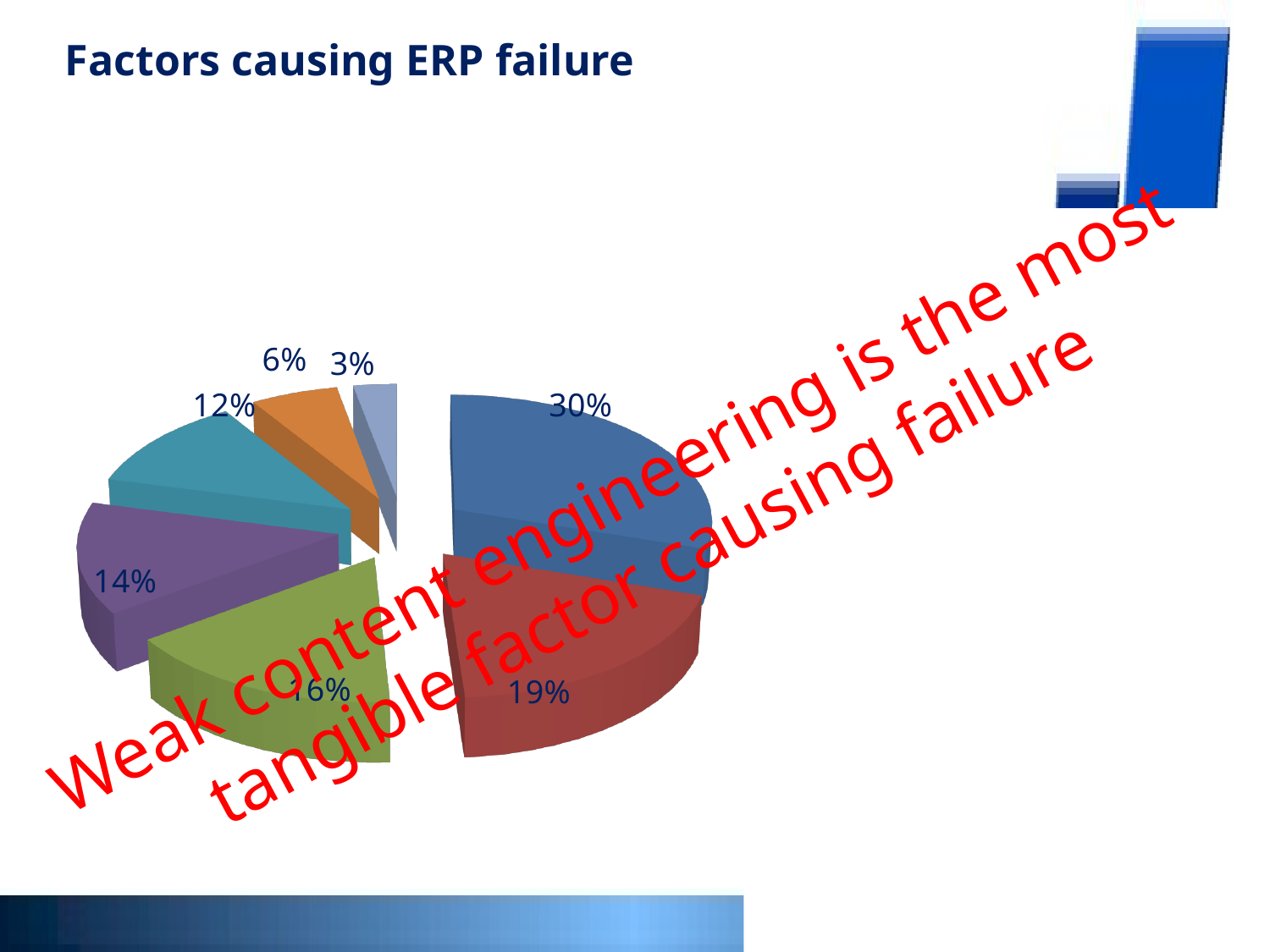
What percentage is shown on the red slice of the pie chart? 19% What percentage is shown on the purple slice of the pie chart? 14% What is the value of the smallest slice in the pie chart? 3% What is the title of the slide containing the pie chart? Factors causing ERP failure How many slices does the pie chart have? 7 What percentage is shown on the green slice of the pie chart? 16% Which slice is larger, the teal slice at 12% or the purple slice at 14%? the purple slice (14%) What percentage is shown on the blue slice of the pie chart? 30% What percentage is shown on the orange slice of the pie chart? 6% What is the difference between the largest slice (30%) and the red slice (19%)? 11% What kind of chart is shown on the slide? pie chart What is the value of the largest slice in the pie chart? 30%